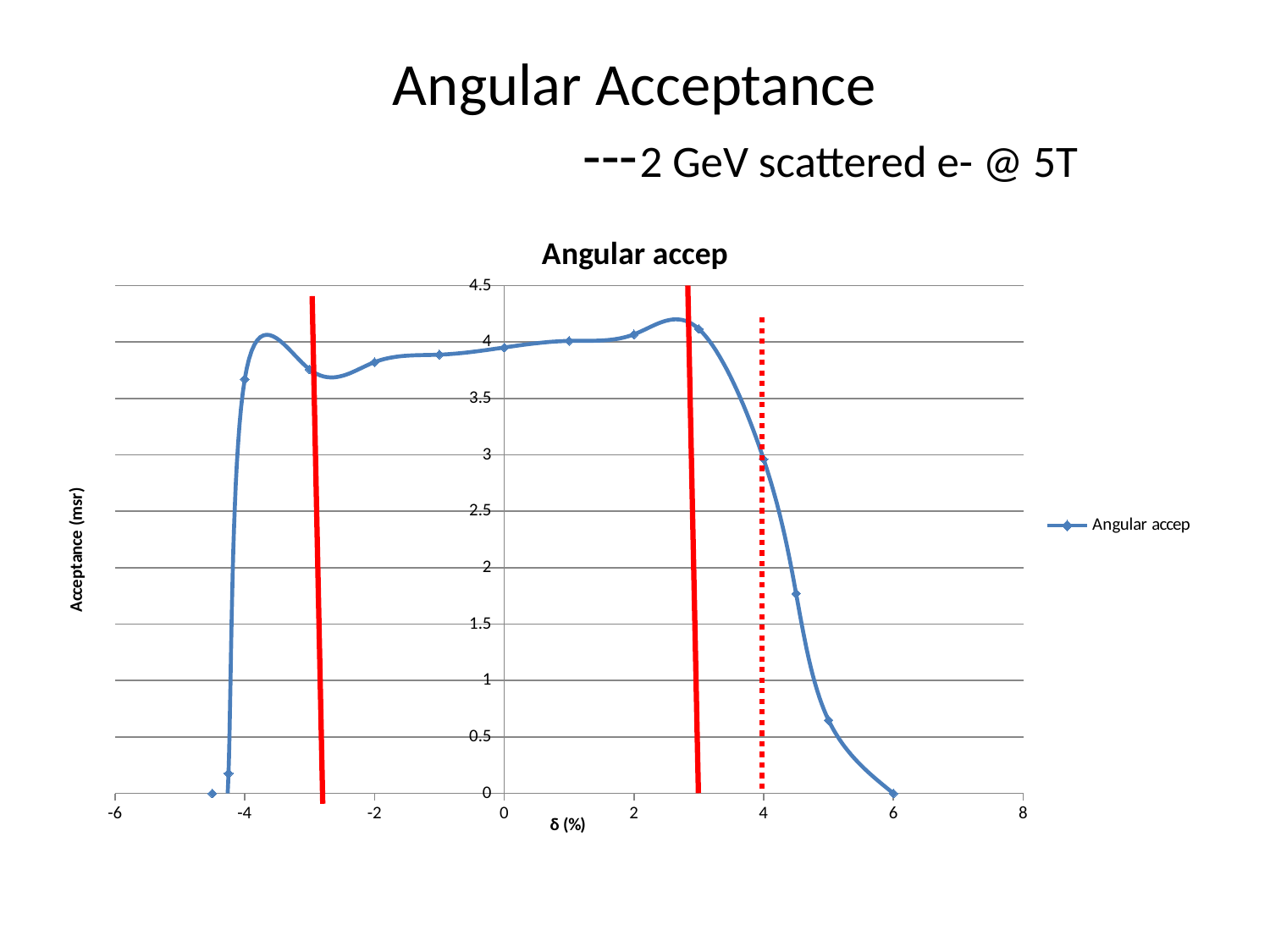
Do the values of Angular accep rise or fall as δ goes from -3 to 2? rise Is the value of Angular accep at δ = 4 greater or less than 2.5? greater Is the value of Angular accep at δ = 0 greater or less than 3.5? greater How many series does the chart legend list? 1 What is the label of the y axis? Acceptance (msr) Which is larger, the value of Angular accep at δ = 4 or at δ = 5? δ = 4 What is the value of Angular accep at δ = 6? 0 What kind of chart is shown on the slide? line chart Is the value of Angular accep at δ = 4.5 greater or less than 2? less Do the values of Angular accep rise or fall as δ goes from 3 to 6? fall What is the title of the chart? Angular accep